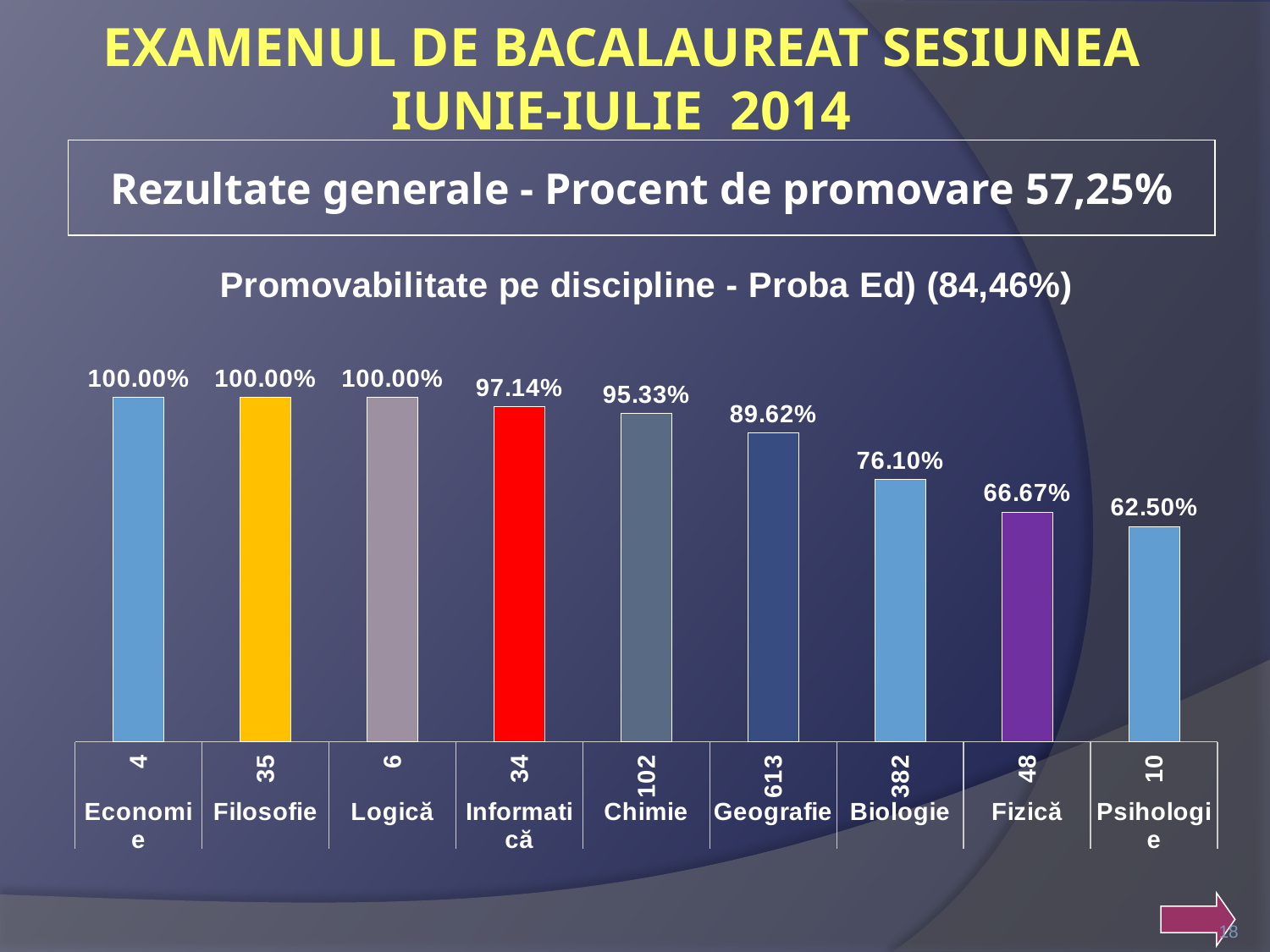
What is the pass rate for Biologie? 76.10% What type of chart is shown? Bar chart How many disciplines are shown in the chart? 9 What is the difference in pass rate between Chimie and Geografie? 5.71% What is the pass rate for Geografie? 89.62% Which discipline has the lowest pass rate? Psihologie What is the difference in pass rate between Informatică and Fizică? 30.47% What is the pass rate for Chimie? 95.33% What number is shown beneath the Geografie bar? 613 Which has a higher pass rate, Biologie or Fizică? Biologie What is the pass rate for Psihologie? 62.50% Do the pass rates rise or fall from left to right across the disciplines? Fall